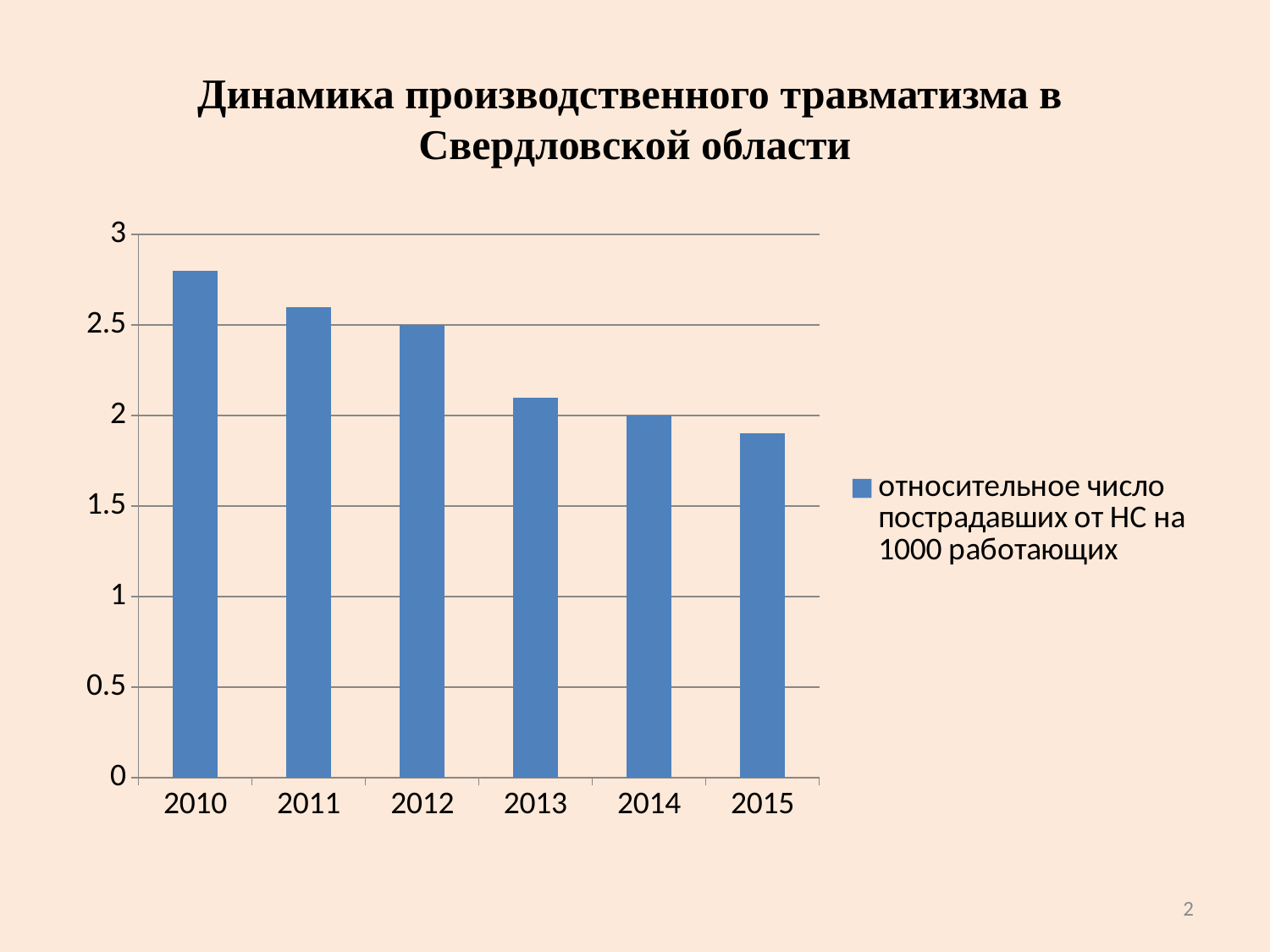
What is the value for 2014? 2 Which year has the lowest value? 2015 How many series does the legend list? 1 Which year has the highest value? 2010 What is the title of the chart on the slide? Динамика производственного травматизма в Свердловской области Which is larger, the value for 2011 or the value for 2013? 2011 What kind of chart is shown on the slide? bar chart Is the value for 2010 greater or less than 2.5? greater Do the values rise or fall from 2010 to 2015? fall How many years are shown on the x axis of the chart? 6 Is the value for 2015 greater or less than 2? less What is the value for 2012? 2.5